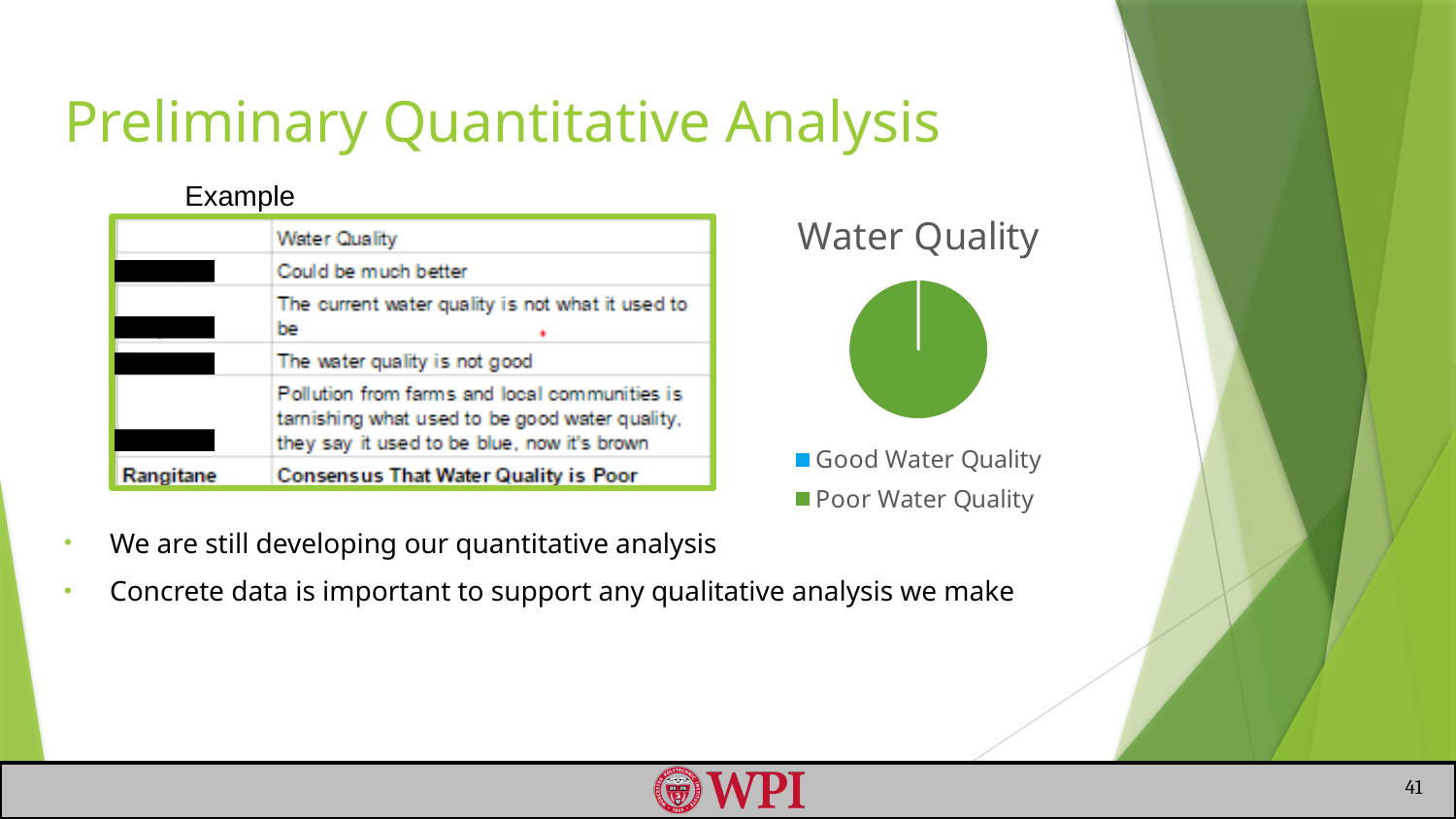
How many categories does the legend of the Water Quality chart list? 2 Which category takes up the smallest share of the Water Quality pie chart? Good Water Quality What colour represents Poor Water Quality in the Water Quality pie chart? green What kind of chart is shown on the slide? pie chart Which category takes up the largest share of the Water Quality pie chart? Poor Water Quality In the Water Quality pie chart, which is larger: Good Water Quality or Poor Water Quality? Poor Water Quality What is the title of the chart? Water Quality